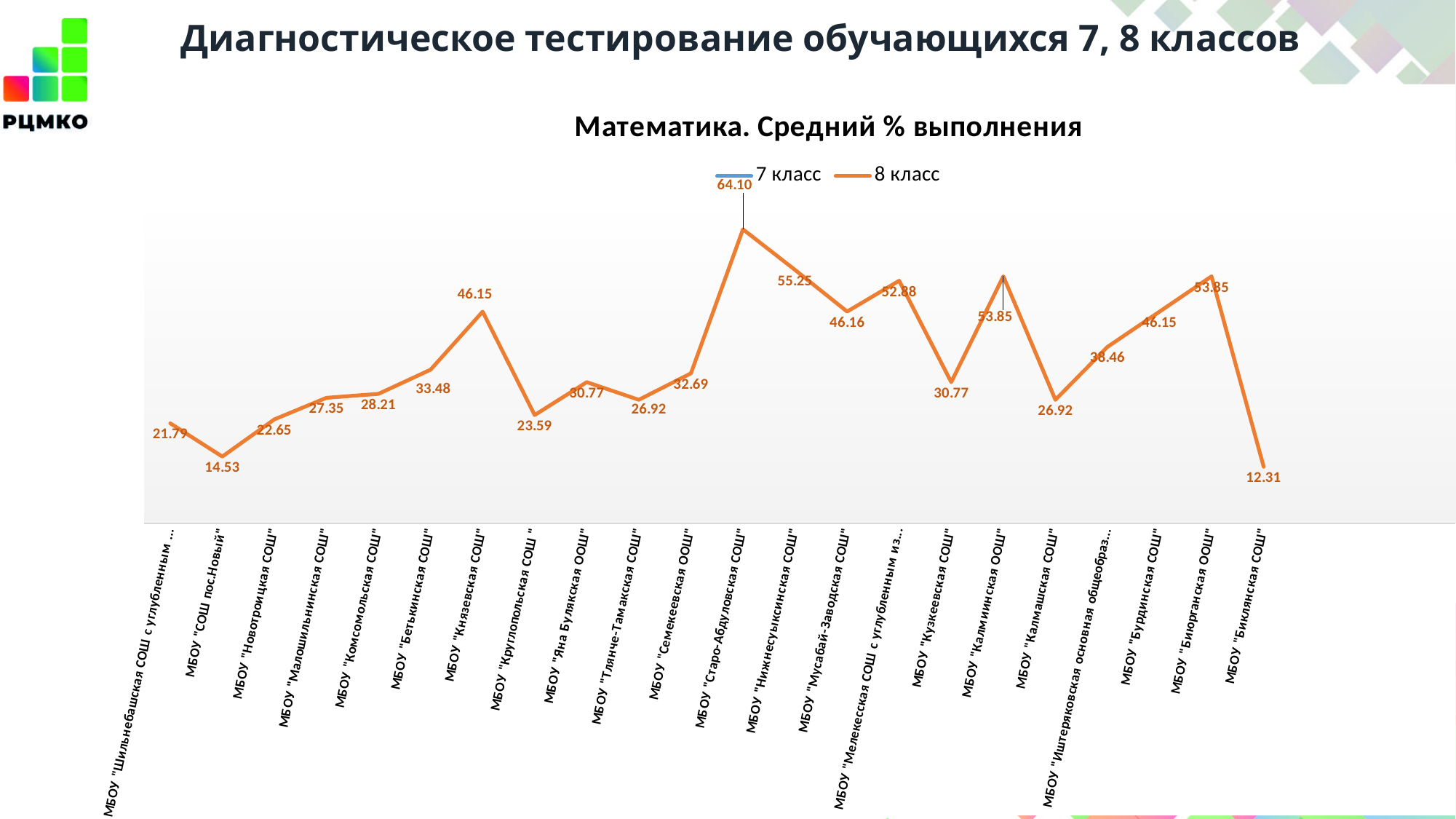
How many series does the legend of the chart list? 2 Which school has the lowest value on the chart? МБОУ "Биклянская СОШ" What is the value shown for МБОУ "Круглопольская СОШ"? 23.59 Which has the larger value: МБОУ "Бурдинская СОШ" or МБОУ "Биюрганская ООШ"? МБОУ "Биюрганская ООШ" What kind of chart is shown on the slide? line chart How many schools are plotted along the x axis of the chart? 22 What is the difference between the values for МБОУ "Нижнесуыксинская СОШ" and МБОУ "Мусабай-Заводская СОШ"? 9.09 What is the title of the chart? Математика. Средний % выполнения Which school has the highest value on the chart? МБОУ "Старо-Абдуловская СОШ" What is the value shown for МБОУ "Князевская СОШ"? 46.15 What is the value shown for МБОУ "Старо-Абдуловская СОШ"? 64.10 What is the value shown for МБОУ "СОШ пос.Новый"? 14.53